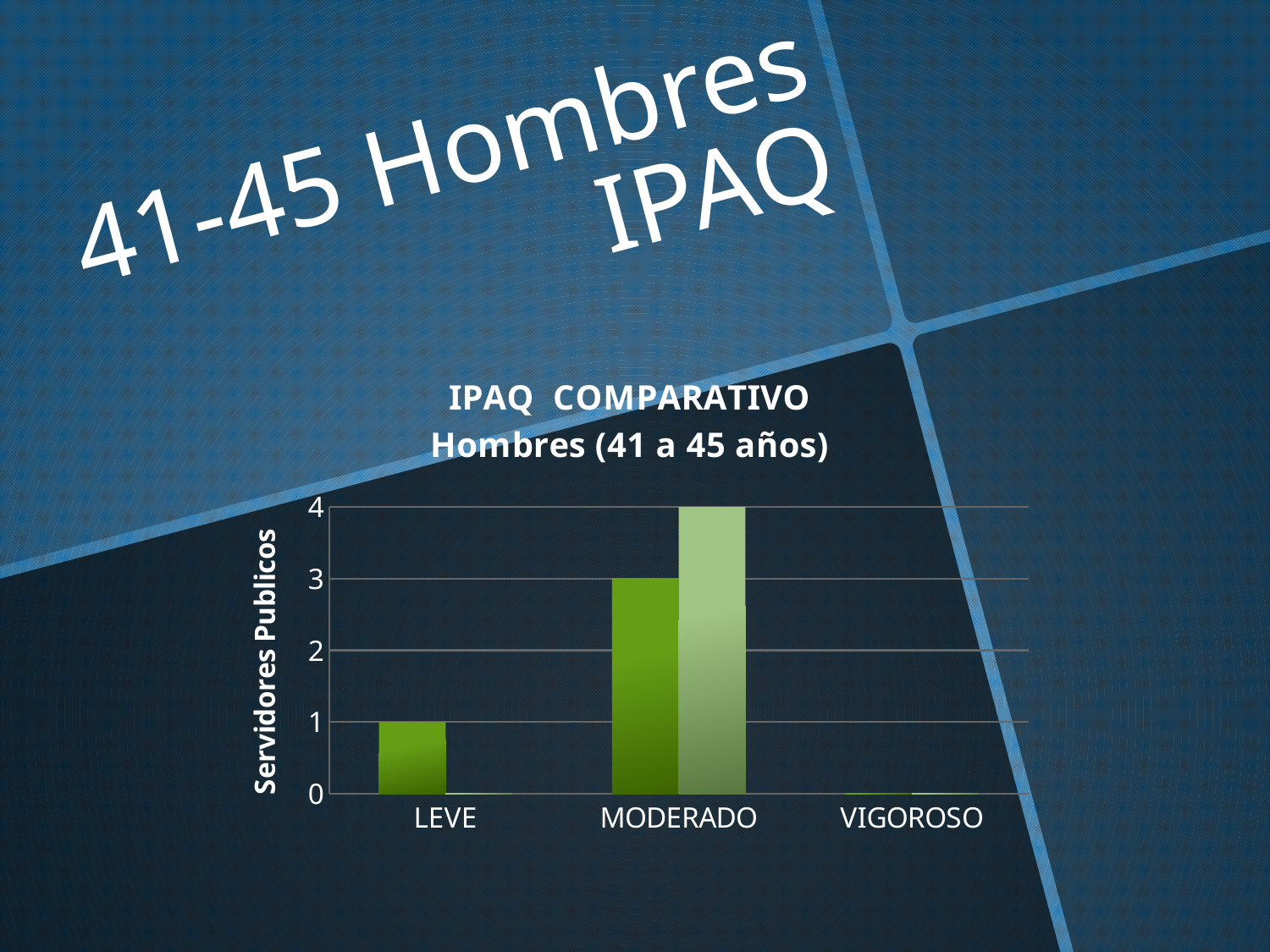
What type of chart is shown on the slide? bar chart Is the dark green bar for MODERADO greater or less than 2? greater What is the value of the dark green bar for MODERADO? 3 What is the title of the chart? IPAQ COMPARATIVO Hombres (41 a 45 años) Which is larger for MODERADO, the dark green bar or the light green bar? the light green bar How many categories are shown on the x axis? 3 What is the difference between the light green bar and the dark green bar for MODERADO? 1 Which category has the lowest values in the chart? VIGOROSO Which category has the highest bar in the chart? MODERADO What is the value of the light green bar for MODERADO? 4 What is the value of the dark green bar for LEVE? 1 What is the label of the vertical axis? Servidores Publicos